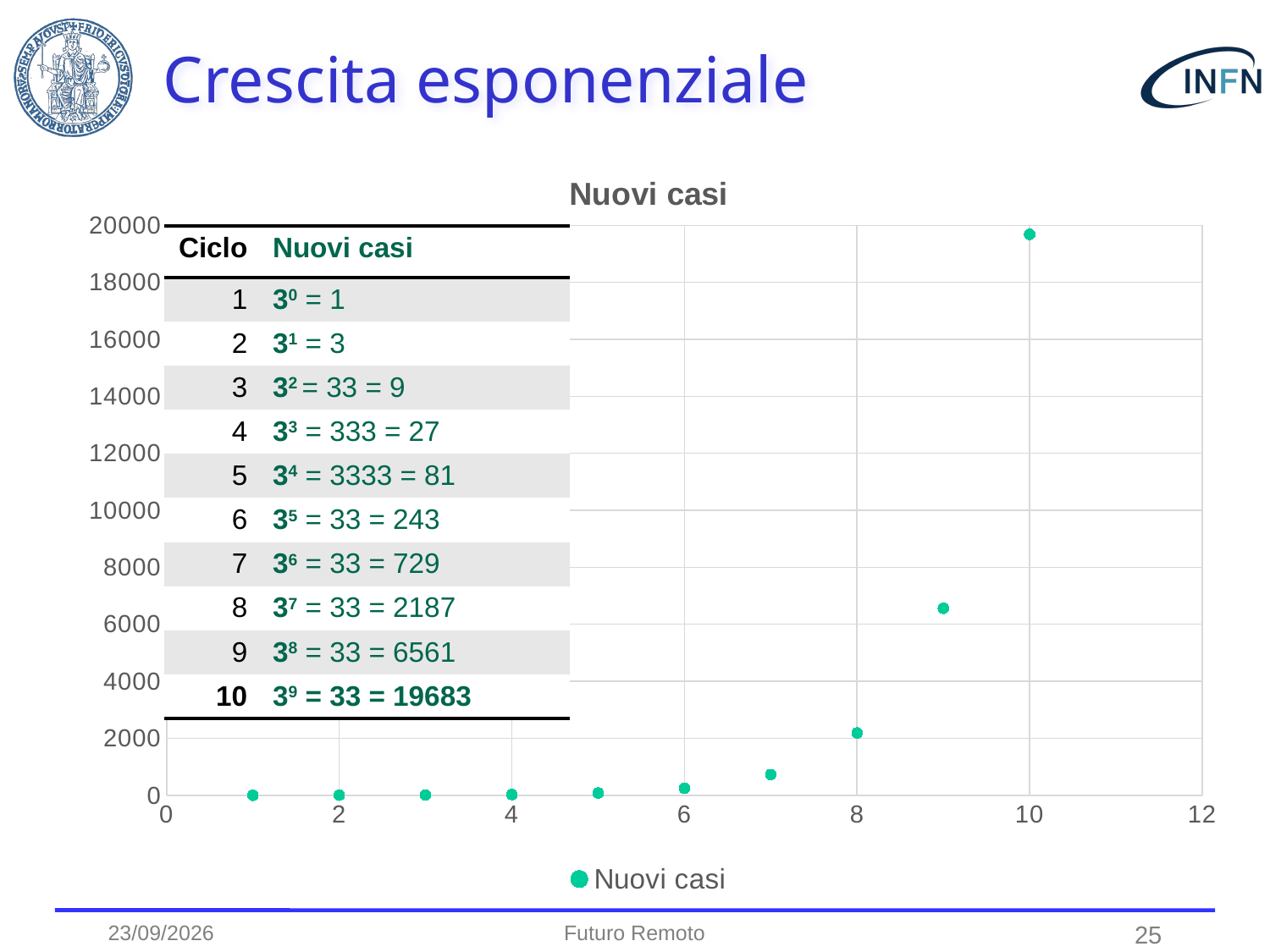
Is the plotted value for cycle 10 greater or less than 18000? greater According to the table, what is the number of Nuovi casi at cycle 9? 6561 What is the difference between the Nuovi casi at cycle 10 and at cycle 9? 13122 At which cycle is the value of Nuovi casi lowest? 1 Is the plotted value for cycle 8 greater or less than 4000? less At which cycle is the value of Nuovi casi highest? 10 Do the values of Nuovi casi rise or fall as the cycle number increases? rise According to the table, what is the number of Nuovi casi at cycle 10? 19683 How many series does the chart legend list? 1 What is the title of the chart? Nuovi casi What kind of chart is shown on the slide? scatter chart How many data points are plotted in the chart? 10